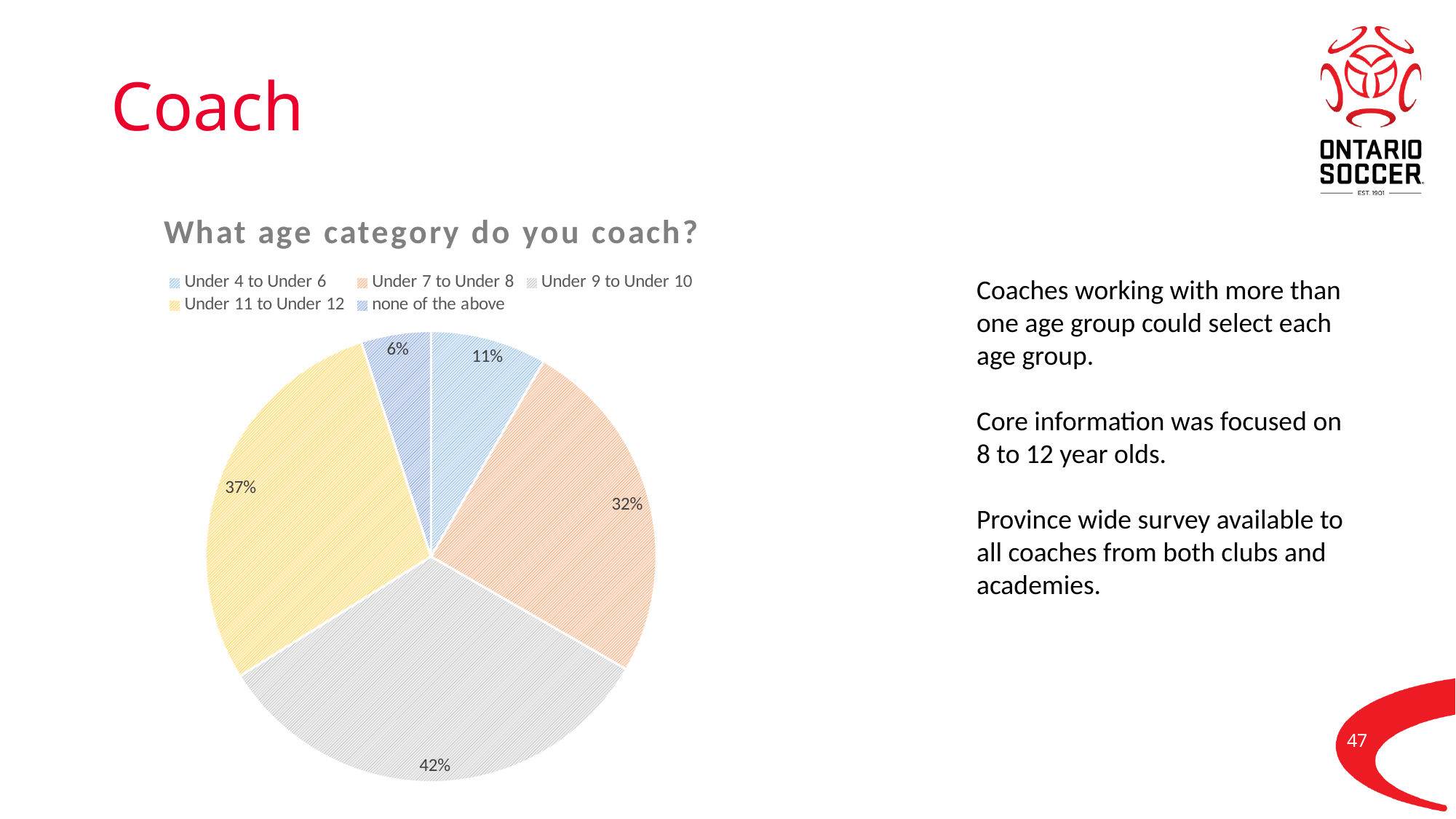
How many slices does the pie chart have? 5 Which has a larger share: Under 11 to Under 12 or Under 7 to Under 8? Under 11 to Under 12 How many entries does the legend list? 5 What percentage of coaches selected 'none of the above'? 6% What type of chart is shown on the slide? Pie chart Which category has the smallest share of the pie? none of the above What percentage of coaches selected Under 4 to Under 6? 11% What is the difference in percentage points between Under 9 to Under 10 and Under 7 to Under 8? 10 What percentage of coaches selected Under 11 to Under 12? 37% What percentage of coaches selected Under 9 to Under 10? 42% What is the title of the chart? What age category do you coach? Which age category has the largest share of the pie? Under 9 to Under 10